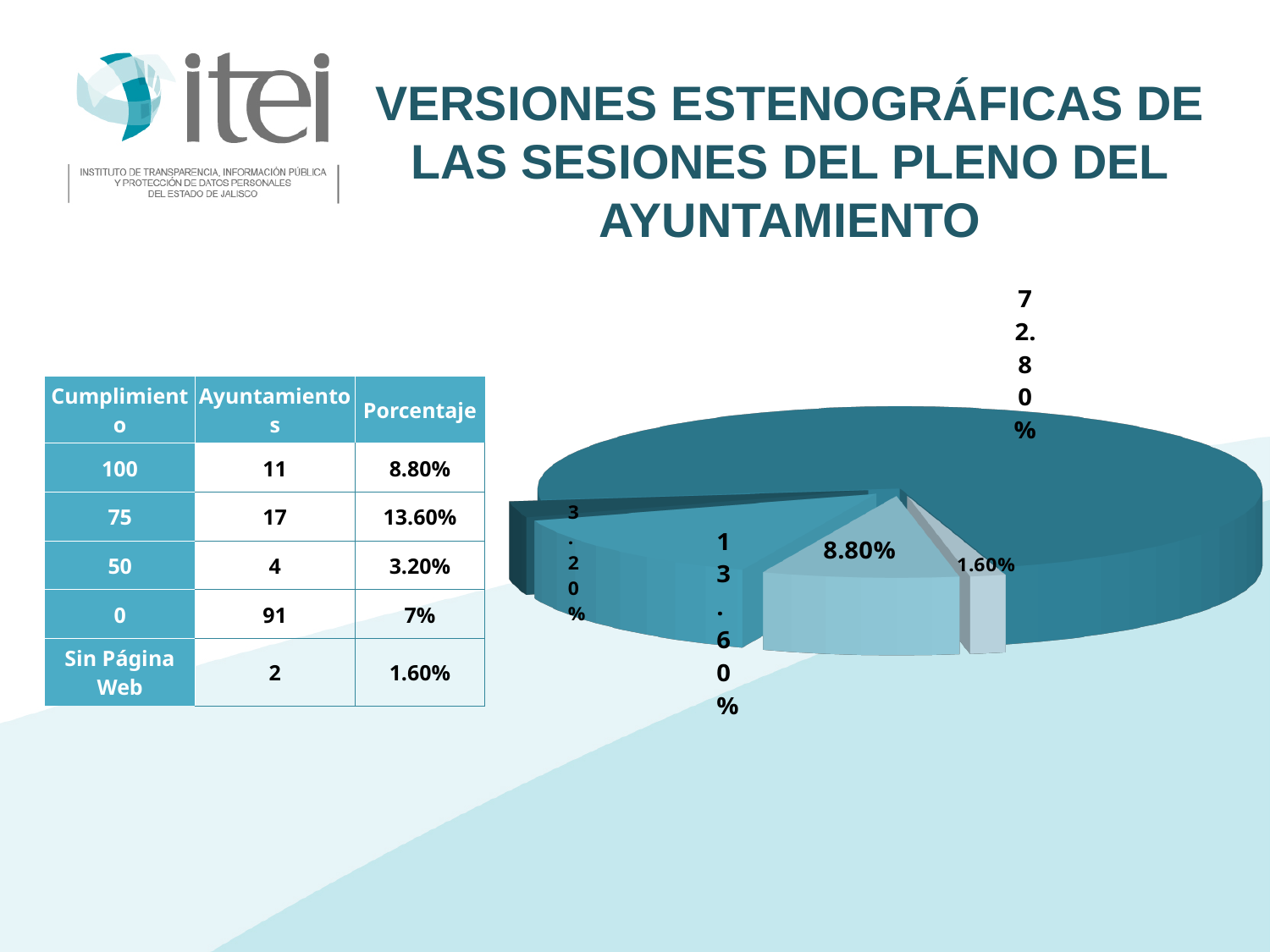
How many slices does the pie chart have? 5 What is the difference between the slice labelled 13.60% and the slice labelled 8.80%? 4.80% Which slice is larger, the one labelled 13.60% or the one labelled 3.20%? 13.60% What is the data label on the largest slice of the pie chart? 72.80% Which slice is larger, the one labelled 8.80% or the one labelled 1.60%? 8.80% What is the sum of the two smallest slice labels, 3.20% and 1.60%? 4.80% Does the pie chart have a legend? No What is the data label on the smallest slice of the pie chart? 1.60% What kind of chart is shown on the slide? pie chart What is the difference between the largest slice (72.80%) and the slice labelled 13.60%? 59.20% Is the largest slice of the pie chart more than half of the pie? Yes